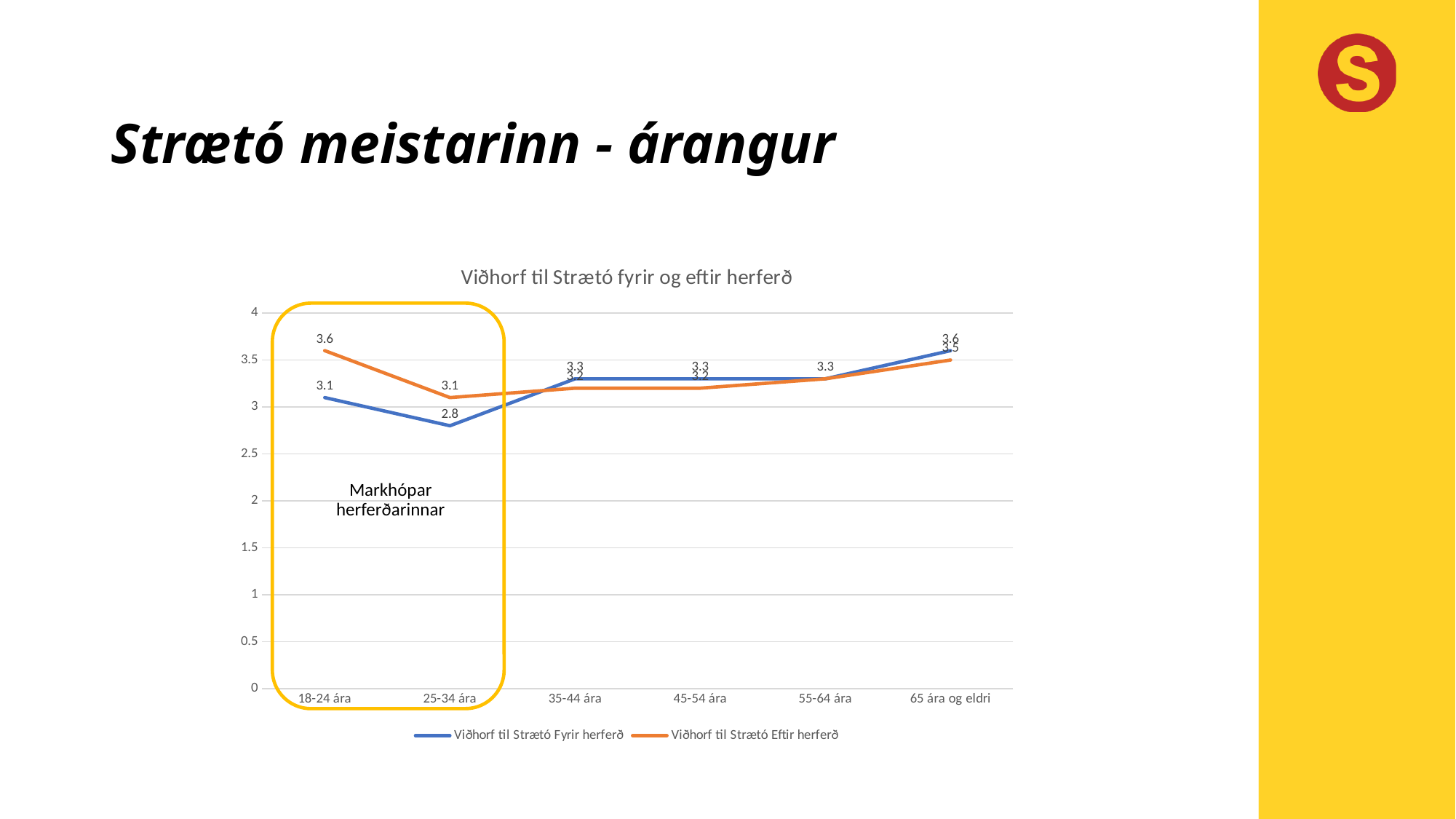
What is the value for 'Viðhorf til Strætó Eftir herferð' for the 25-34 ára group? 3.1 How many series does the legend list? 2 Which age group has the highest value for 'Viðhorf til Strætó Eftir herferð'? 18-24 ára What is the difference between 'Viðhorf til Strætó Eftir herferð' and 'Viðhorf til Strætó Fyrir herferð' for the 18-24 ára group? 0.5 How many age categories are shown on the x axis? 6 What is the value for 'Viðhorf til Strætó Eftir herferð' for the 18-24 ára group? 3.6 Which colour is used for the 'Viðhorf til Strætó Eftir herferð' line? orange For the 25-34 ára group, which is larger: 'Viðhorf til Strætó Fyrir herferð' or 'Viðhorf til Strætó Eftir herferð'? Viðhorf til Strætó Eftir herferð What is the title of the chart? Viðhorf til Strætó fyrir og eftir herferð What is the value for 'Viðhorf til Strætó Fyrir herferð' for the 25-34 ára group? 2.8 Which age group has the lowest value for 'Viðhorf til Strætó Fyrir herferð'? 25-34 ára What type of chart is shown on the slide? line chart